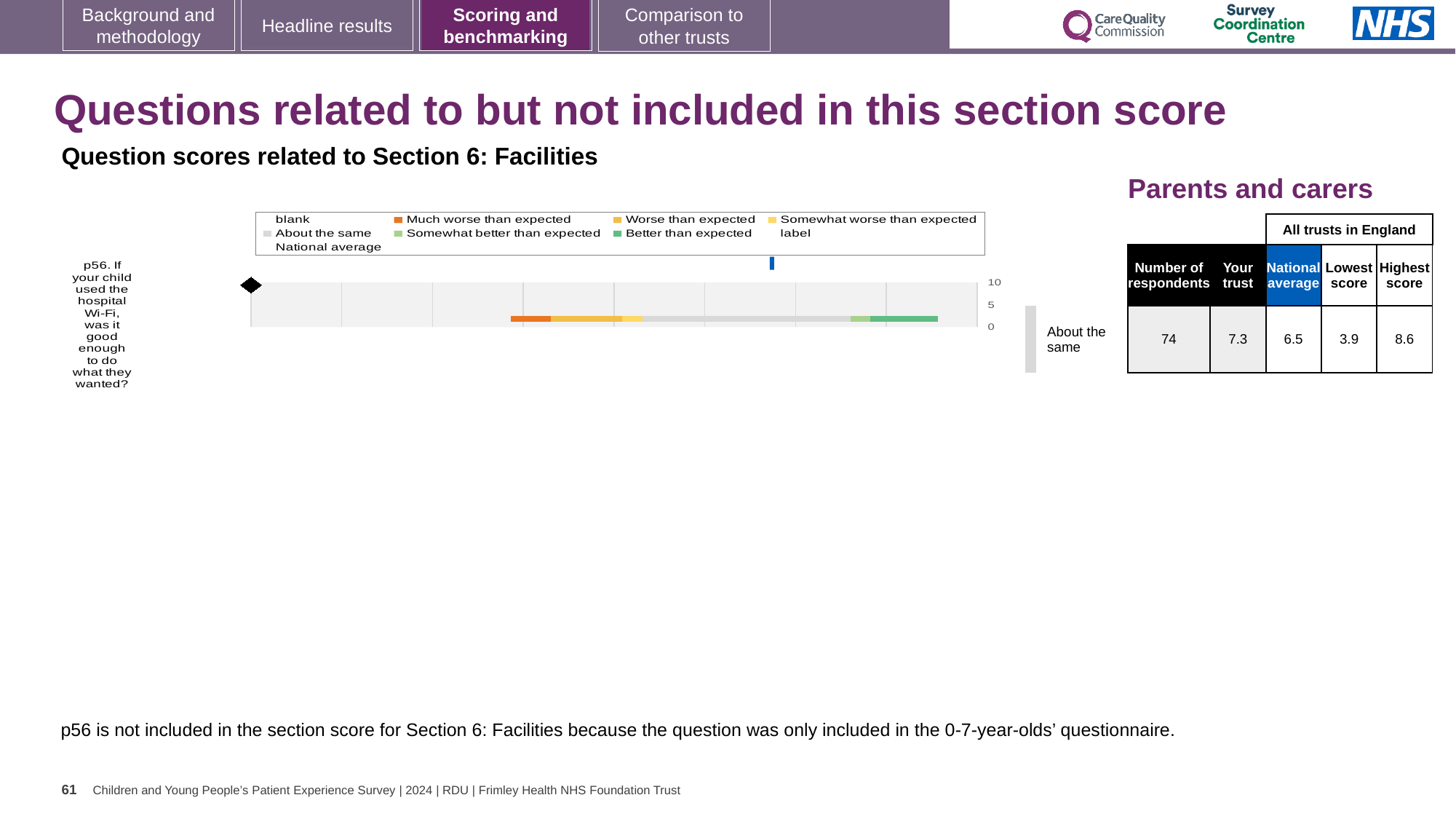
Which is larger for p56, the trust's score or the national average? Your trust What kind of chart is used to show the p56 question score? bar chart How many respondents answered p56? 74 How many questions are plotted in the chart? 1 What is the highest score among all trusts in England for p56? 8.6 What is the highest value shown on the chart's axis? 10 What is the lowest score among all trusts in England for p56? 3.9 What is the 'Your trust' score for p56 (hospital Wi-Fi)? 7.3 What is the national average score for p56? 6.5 What is the difference between the trust's p56 score and the national average? 0.8 Which benchmark category is the trust's p56 score labelled as on the chart? About the same What is the difference between the highest and lowest trust scores for p56? 4.7